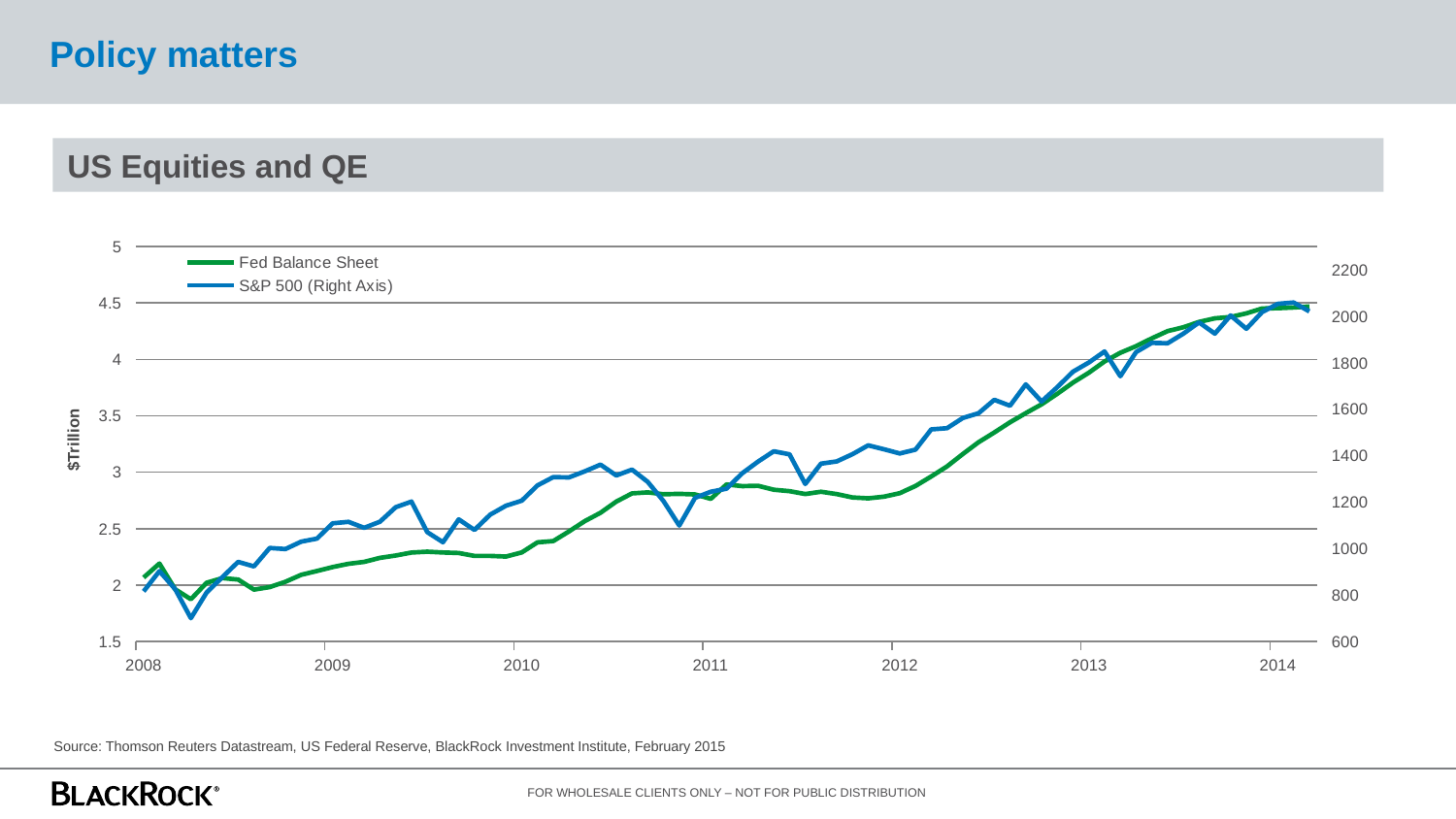
What is the title of the chart? US Equities and QE Does the Fed Balance Sheet rise or fall overall from 2008 to 2014? rise Is the value for the Fed Balance Sheet at 2014 greater or less than 4? greater In which year shown does the Fed Balance Sheet reach its highest level? 2014 Which series is plotted on the right axis? S&P 500 Is the value for the S&P 500 at 2014 greater or less than 1800? greater Does the S&P 500 rise or fall overall from 2009 to 2014? rise Is the value for the Fed Balance Sheet at 2012 greater or less than 3? less What kind of chart is shown on the slide? line chart How many series does the legend list? 2